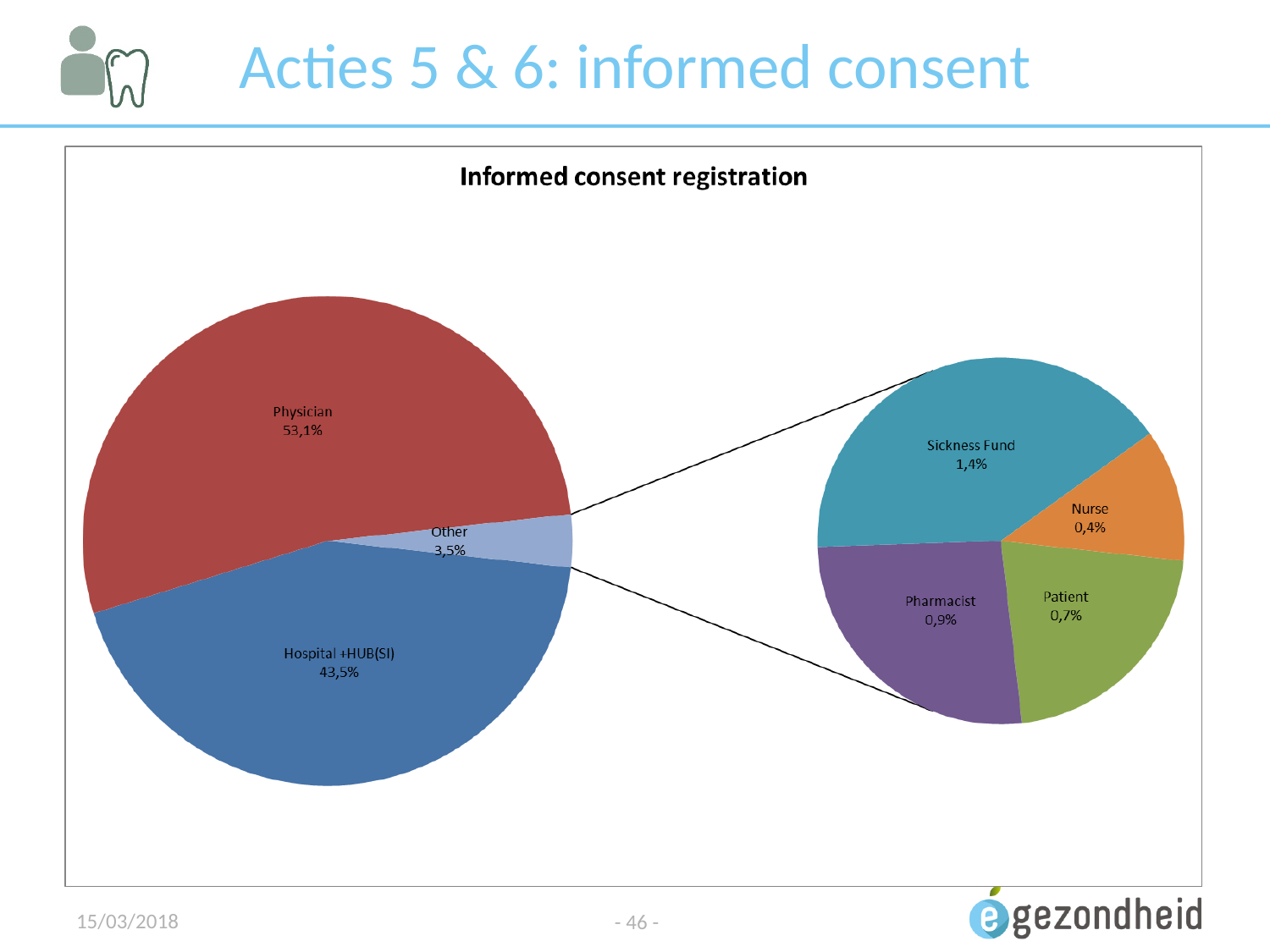
What share is shown for Hospital +HUB(SI)? 43,5% Which category has the largest share in the chart? Physician Which has a larger share, Pharmacist or Patient? Pharmacist What share is shown for Sickness Fund in the secondary pie? 1,4% What is the title of the chart? Informed consent registration What share is shown for Nurse? 0,4% What share is shown for the Other slice in the main pie? 3,5% Which category has the smallest share in the chart? Nurse What is the difference in percentage points between Physician and Hospital +HUB(SI)? 9,6 How many categories are shown in the secondary (breakout) pie? 4 What share of informed consent registrations is attributed to Physician? 53,1% What kind of chart is shown on the slide? Pie chart